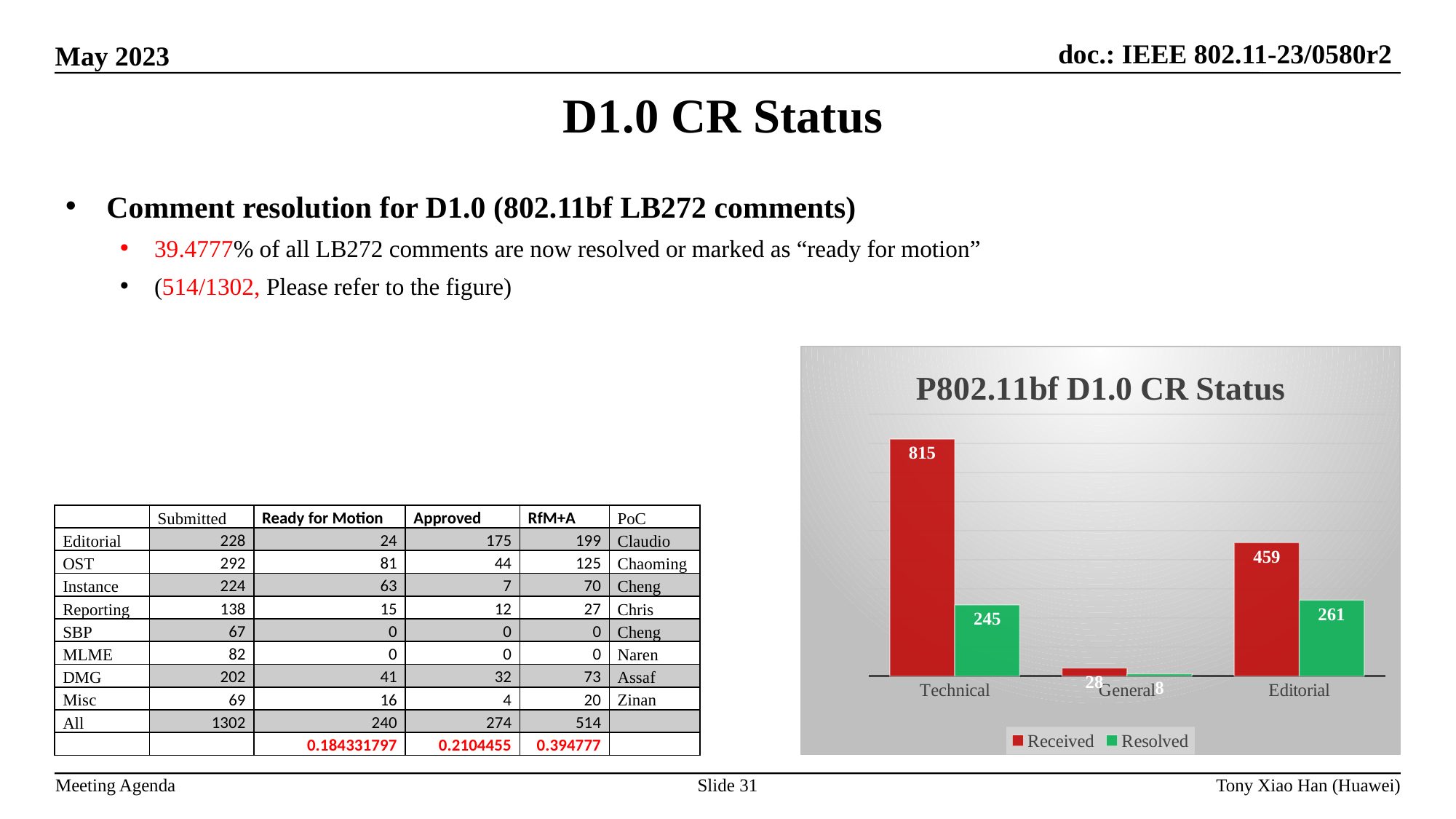
What is the difference between Received and Resolved for Technical in the P802.11bf D1.0 CR Status chart? 570 What is the difference between Received and Resolved for Editorial in the P802.11bf D1.0 CR Status chart? 198 In the P802.11bf D1.0 CR Status chart, is the Resolved value larger for Technical or for Editorial? Editorial What kind of chart is the P802.11bf D1.0 CR Status chart? Bar chart How many series does the legend of the P802.11bf D1.0 CR Status chart list? 2 What is the Received value for General in the P802.11bf D1.0 CR Status chart? 28 Which category has the lowest Resolved value in the P802.11bf D1.0 CR Status chart? General What is the Resolved value for Editorial in the P802.11bf D1.0 CR Status chart? 261 What is the Received value for Technical in the P802.11bf D1.0 CR Status chart? 815 What is the Resolved value for Technical in the P802.11bf D1.0 CR Status chart? 245 Which category has the highest Received value in the P802.11bf D1.0 CR Status chart? Technical How many categories are shown on the x axis of the P802.11bf D1.0 CR Status chart? 3